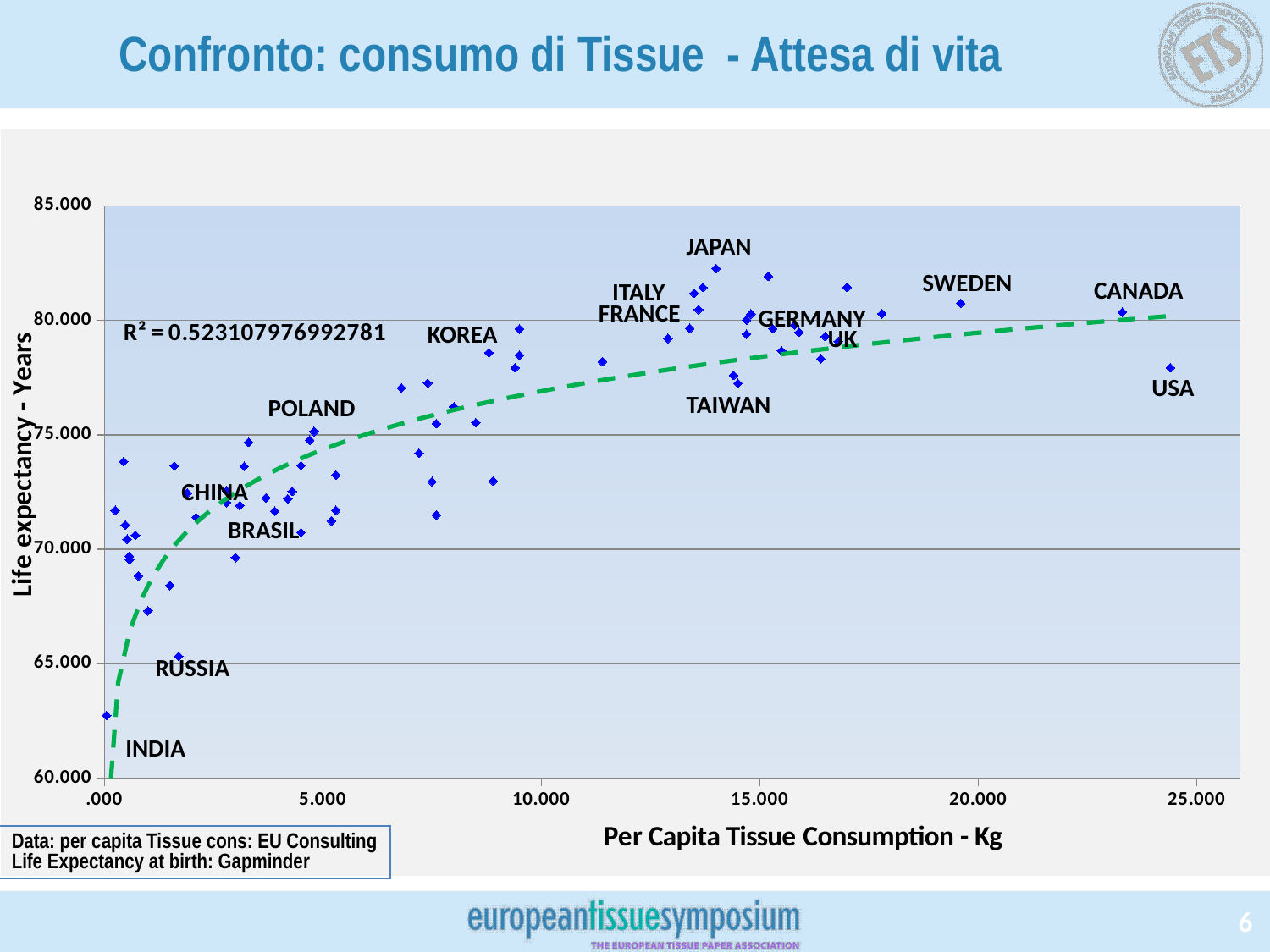
Does the trend line show life expectancy rising or falling as per capita tissue consumption increases? Rising What is the title of the y axis of the chart? Life expectancy - Years What kind of chart is shown on the slide? Scatter chart Which labelled country has the highest life expectancy on the chart? JAPAN Which has the higher life expectancy, JAPAN or USA? JAPAN Is the life expectancy for USA greater or less than 80.000? less Which labelled country has the lowest per capita tissue consumption on the chart? INDIA What is the R² value printed on the chart? R² = 0.523107976992781 Is the life expectancy for JAPAN greater or less than 80.000? greater Which labelled country has the lowest life expectancy on the chart? INDIA What is the title of the x axis of the chart? Per Capita Tissue Consumption - Kg Is the per capita tissue consumption for CANADA greater or less than 20.000? greater